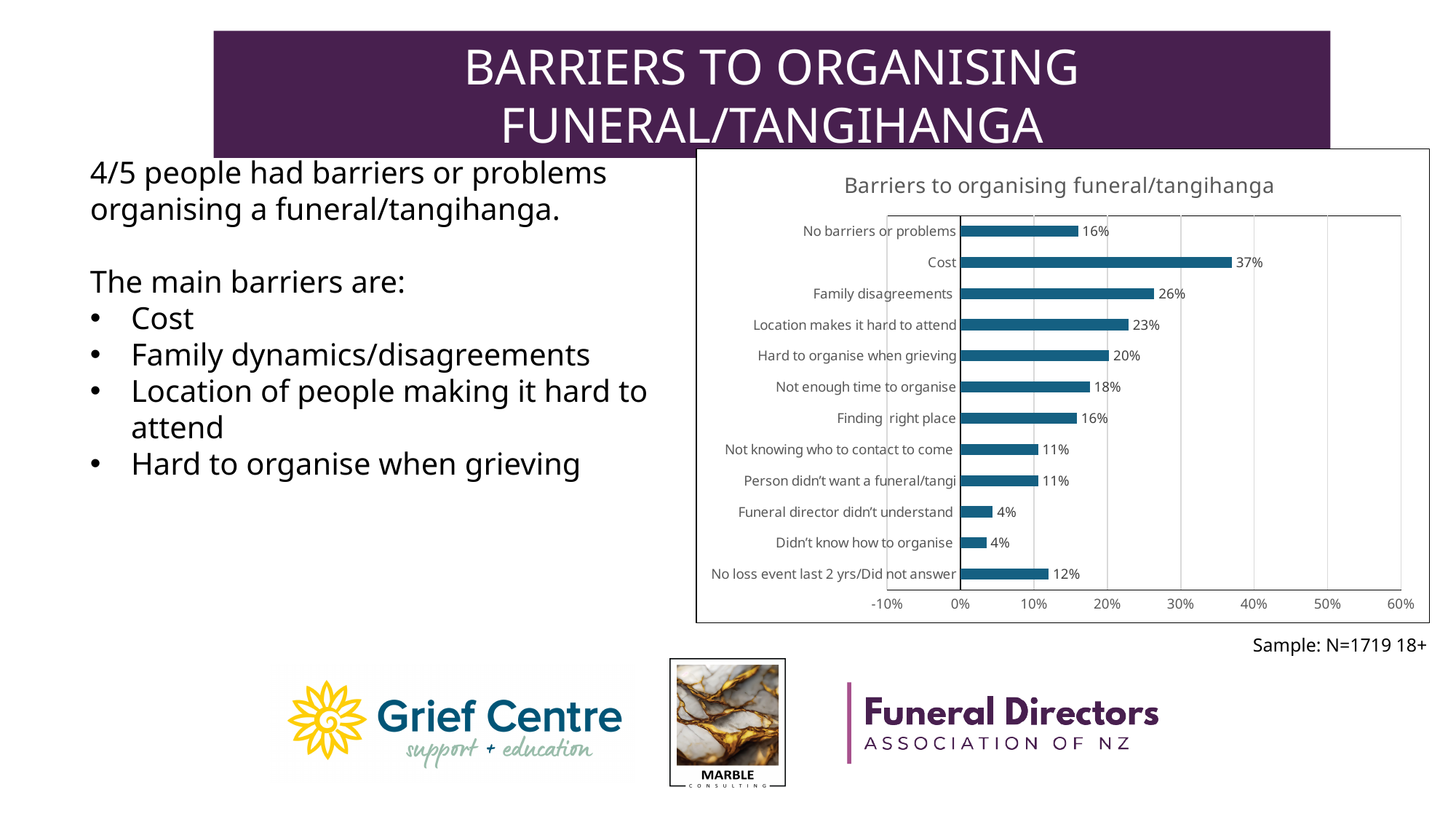
Which category has the highest value? Cost What is the difference between the values for Cost and Family disagreements? 11% What kind of chart is shown on the slide? bar chart What is the value for Cost? 37% What is the title of the chart? Barriers to organising funeral/tangihanga What is the value for Hard to organise when grieving? 20% Which is larger, the value for Location makes it hard to attend or the value for Not enough time to organise? Location makes it hard to attend How many categories are shown in the chart? 12 What is the value for No loss event last 2 yrs/Did not answer? 12% What is the difference between the values for No barriers or problems and Didn't know how to organise? 12% Is the value for Cost greater or less than 30%? greater What is the value for Family disagreements? 26%